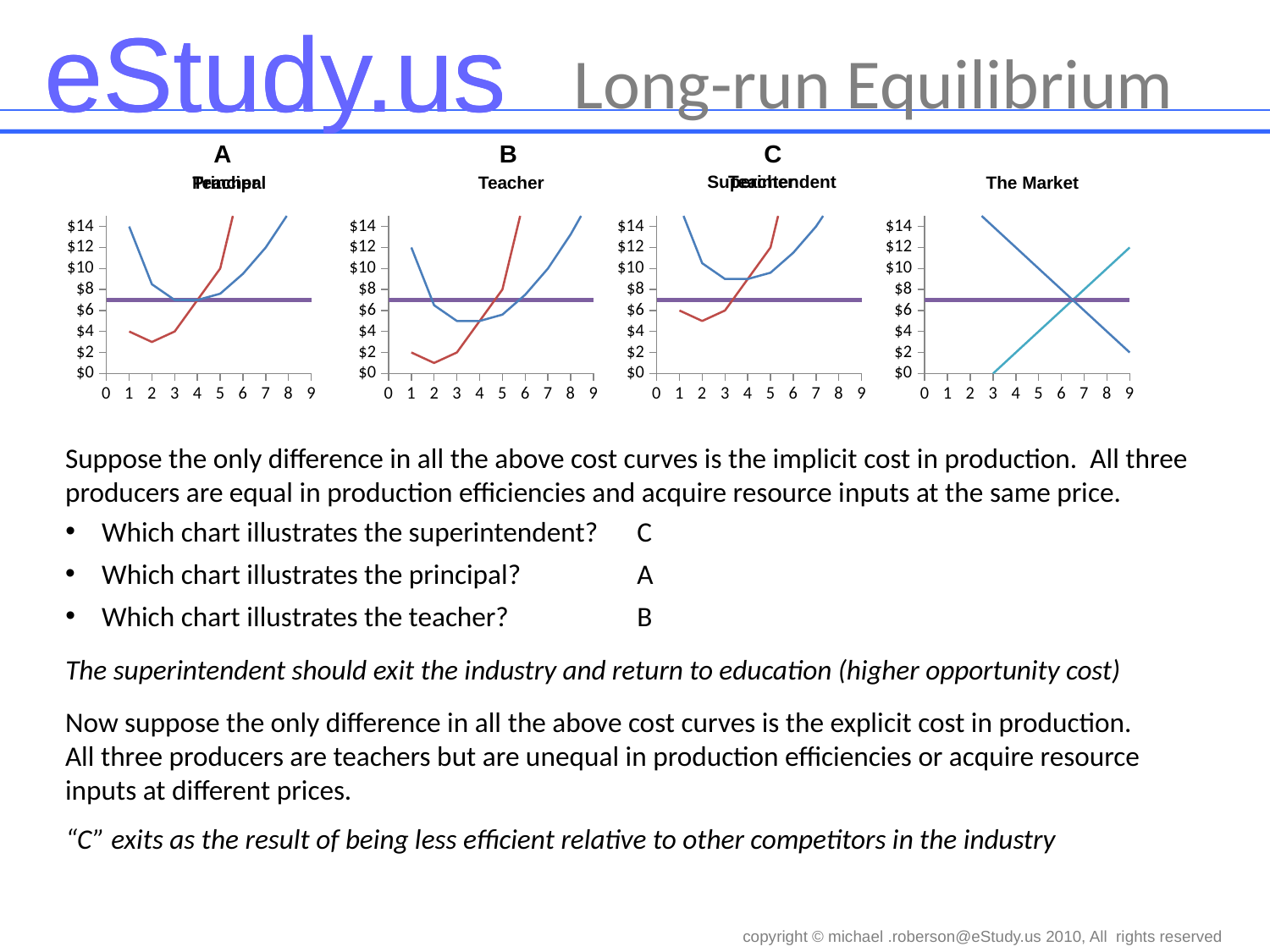
In the chart titled 'The Market', is the value of the light blue line at x = 9 greater or less than $10? greater In the chart titled 'The Market', does the dark blue line rise or fall as the x axis increases? fall In the chart titled 'The Market', does the light blue line rise or fall as the x axis increases? rise In chart C, is the lowest point of the blue curve greater or less than $8? greater What is the title of the fourth (rightmost) chart? The Market What is the highest value labelled on the vertical axis of chart A? $14 In chart A, is the value of the red curve at x = 2 greater or less than $4? less How many charts are shown on the slide? 4 What is the title of chart B? Teacher What kind of chart is the chart titled 'The Market'? line chart